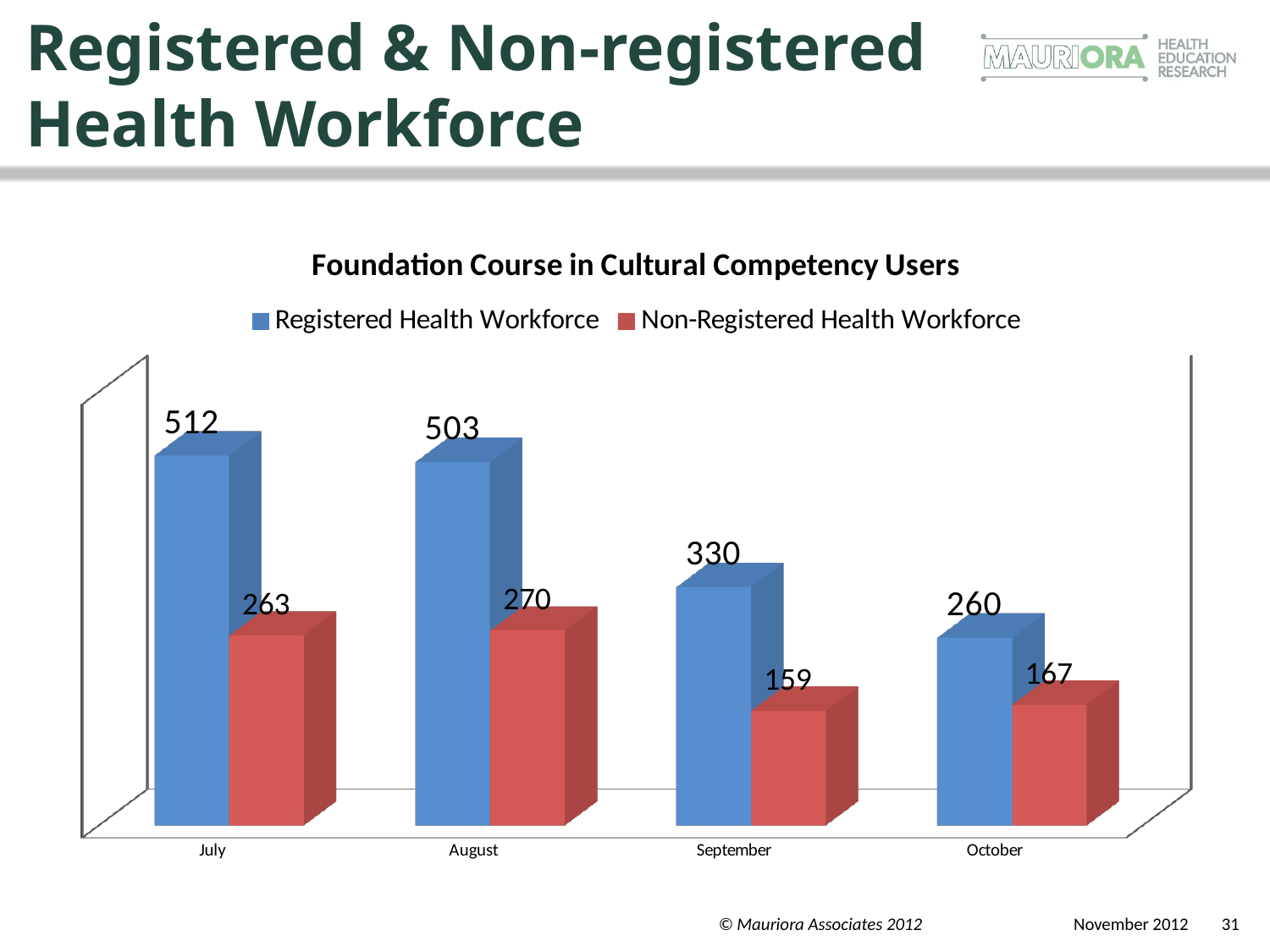
What is the difference between the Registered and Non-Registered Health Workforce values in August? 233 How many months are shown on the x axis? 4 What is the title of the chart? Foundation Course in Cultural Competency Users Which month has the highest value for Registered Health Workforce? July Which is larger: the Non-Registered Health Workforce value in July or in August? August What is the value for Registered Health Workforce in July? 512 What is the value for Registered Health Workforce in October? 260 How many series does the legend list? 2 What is the value for Non-Registered Health Workforce in September? 159 Does the Registered Health Workforce value rise or fall from July to October? Fall What kind of chart is shown on the slide? Bar chart Which month has the lowest value for Non-Registered Health Workforce? September